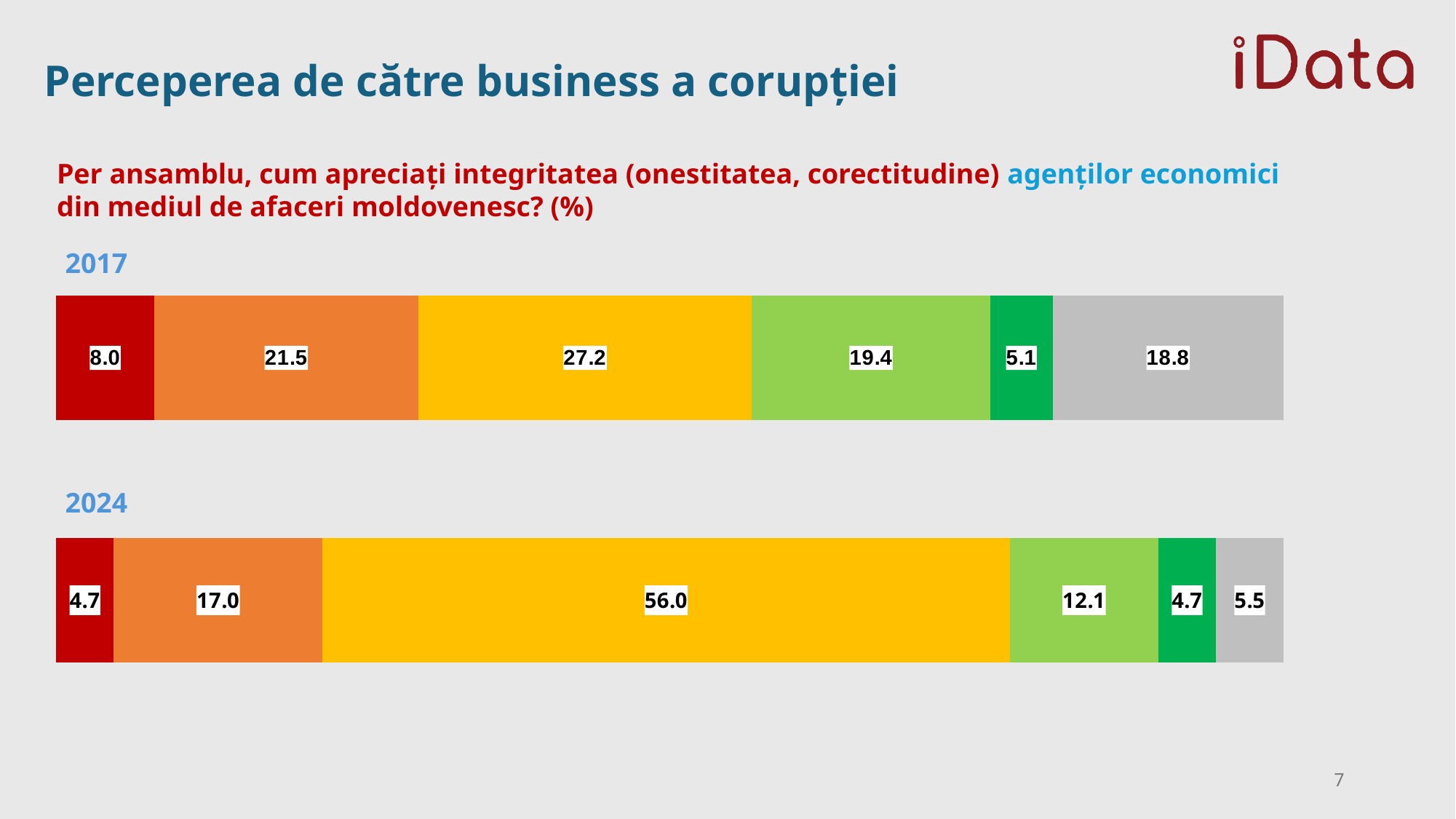
What is the value of the grey segment in the 2017 bar? 18.8 By how much did the yellow segment change from 2017 (27.2) to 2024 (56.0)? 28.8 What is the value of the yellow segment in the 2024 bar? 56.0 What is the total of all segments in the 2017 bar? 100.0 Which is larger: the light green segment in 2017 or the light green segment in 2024? 2017 (19.4) What is the value of the orange segment in the 2024 bar? 17.0 What is the value of the red segment in the 2017 bar? 8.0 What is the difference between the grey segment in 2017 (18.8) and in 2024 (5.5)? 13.3 Which segment has the smallest value in the 2017 bar? The dark green segment (5.1) What type of chart is shown on the slide? Stacked bar chart How many segments does each stacked bar contain? 6 Which segment has the largest value in the 2024 bar? The yellow segment (56.0)